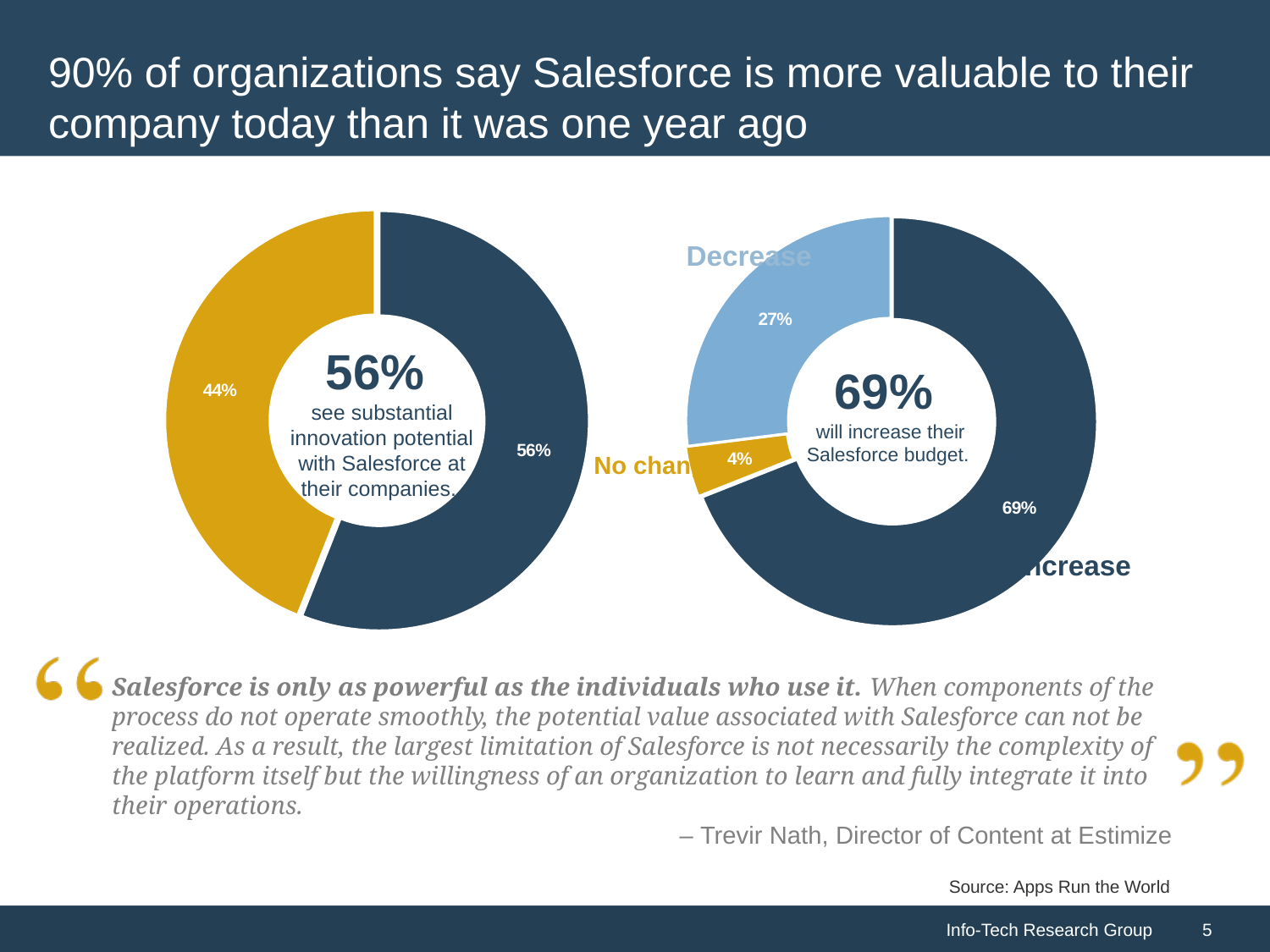
In the left chart, what percentage see substantial innovation potential with Salesforce at their companies? 56% In the right chart, what is the difference between the 69% slice and the Decrease slice? 42% How many slices does the right chart have? 3 In the left chart, what is the value of the gold slice? 44% In the left chart, which slice is larger, the dark blue one or the gold one? The dark blue one (56%) In the right chart, which slice is the largest? The dark blue slice (69%) What type of charts are shown on the slide? Donut (pie) charts In the right chart, what is the value of the gold slice? 4% In the right chart, what percentage will increase their Salesforce budget? 69% In the right chart, which slice is the smallest? The gold slice (4%) In the right chart, what is the value of the Decrease slice? 27% In the left chart, what is the difference between the dark blue slice and the gold slice? 12%